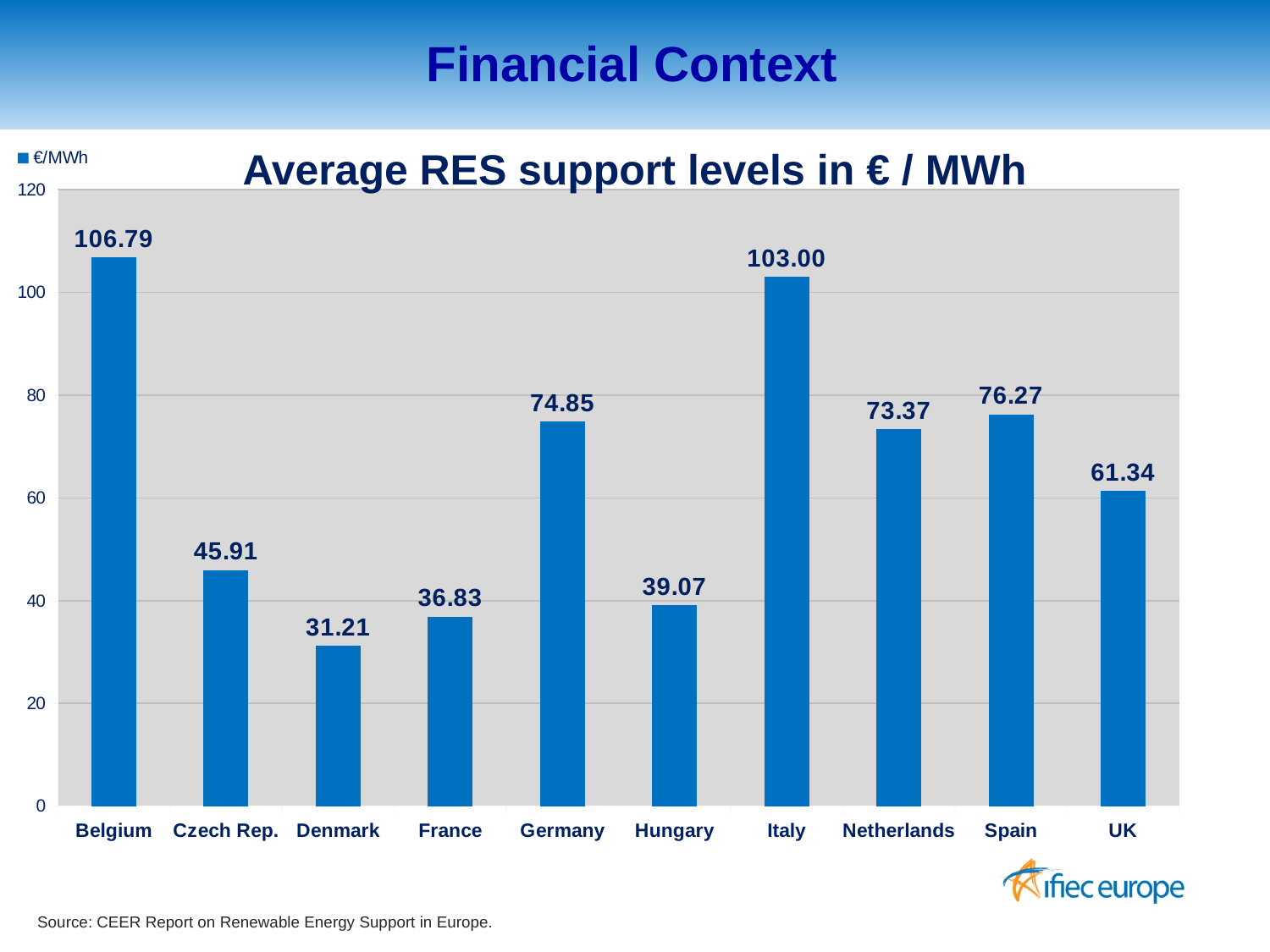
Which has a higher value, Czech Rep. or Hungary? Czech Rep. What is the difference between the values for Belgium and Italy? 3.79 Which country has the lowest average RES support level? Denmark What kind of chart is shown on the slide? bar chart What is the average RES support level for Germany? 74.85 How many countries are shown in the chart? 10 What is the difference between the values for Spain and the UK? 14.93 What is the title of the chart? Average RES support levels in € / MWh What is the value shown for the Netherlands? 73.37 Which country has the highest average RES support level? Belgium Is the value for France greater or less than 40? less How many series does the legend list? 1